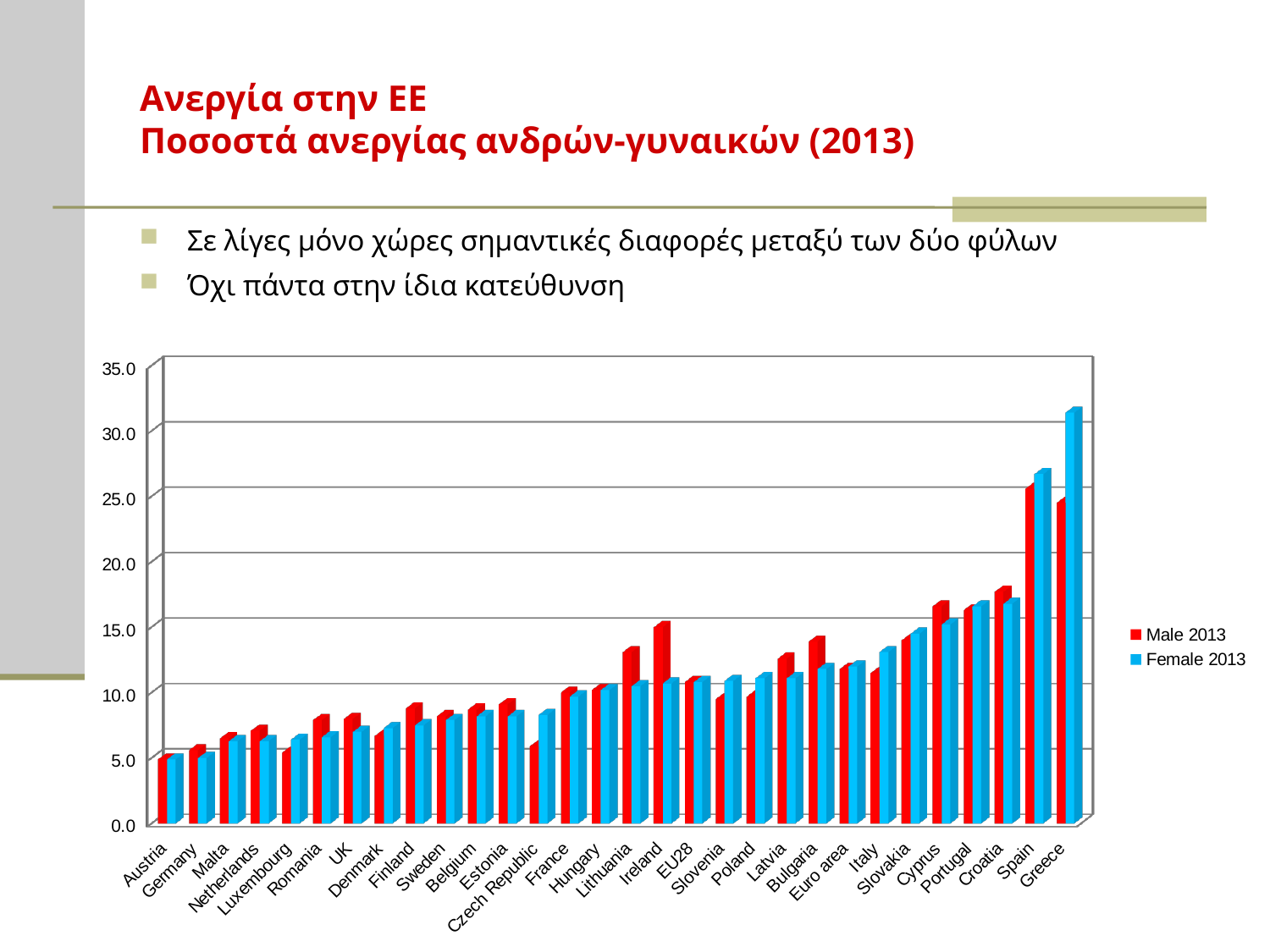
Is the Female 2013 value for Ireland greater or less than 15.0? less Is the Male 2013 value for Spain greater or less than 25.0? greater For Greece, which is larger: the Male 2013 or the Female 2013 value? Female 2013 Do the values generally rise or fall moving from Austria to Greece along the x axis? rise What kind of chart is shown on the slide? bar chart Which country has the highest Male 2013 unemployment rate? Spain For Ireland, which is larger: the Male 2013 or the Female 2013 value? Male 2013 Is the Female 2013 value for Greece greater or less than 30.0? greater How many countries/regions are shown on the x axis? 30 Which colour represents the Male 2013 series in the legend? red Which country has the highest Female 2013 unemployment rate? Greece How many series does the legend list? 2